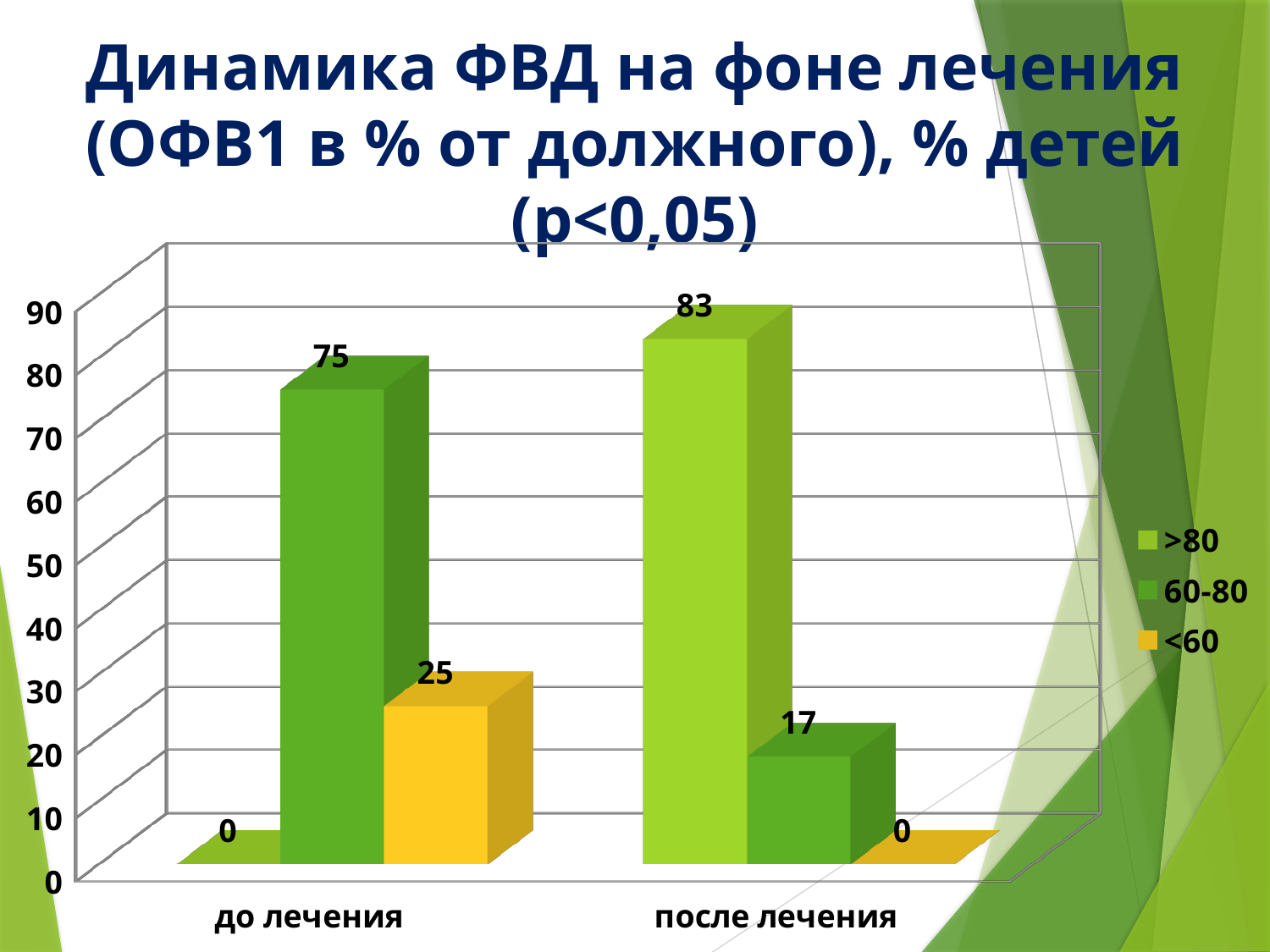
How many series does the legend list? 3 What is the difference between the '60-80' values for 'до лечения' and 'после лечения'? 58 Which is larger: the '<60' value for 'до лечения' or the '60-80' value for 'после лечения'? '<60' value for 'до лечения' Which series has the highest value in the 'после лечения' category? >80 What is the value for the '<60' series in the 'после лечения' category? 0 What is the value for the '>80' series in the 'до лечения' category? 0 What is the value for the '60-80' series in the 'до лечения' category? 75 What kind of chart is shown on the slide? Bar chart What is the value for the '>80' series in the 'после лечения' category? 83 What is the value for the '<60' series in the 'до лечения' category? 25 How many categories are shown on the x axis? 2 What is the value for the '60-80' series in the 'после лечения' category? 17